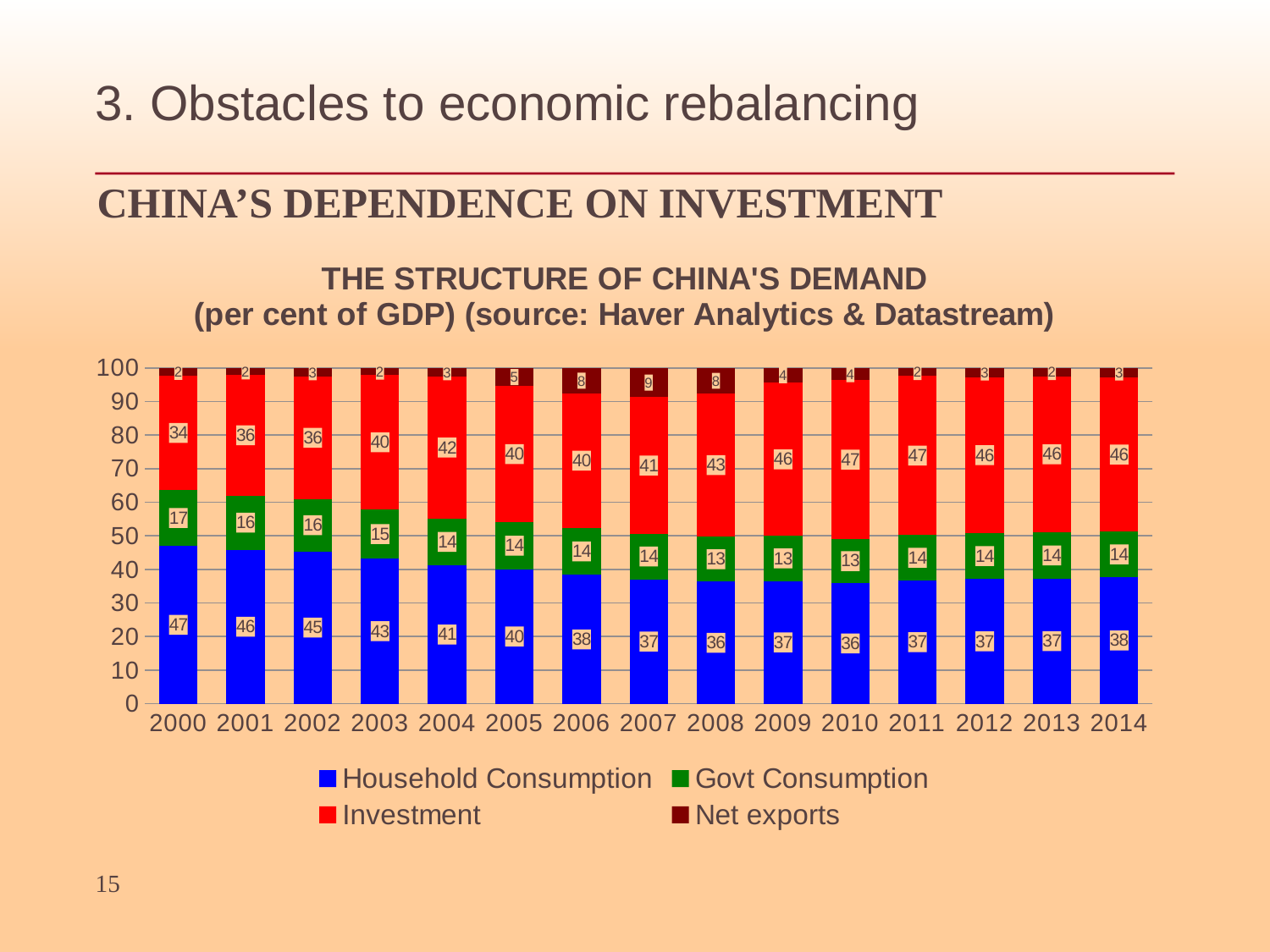
What is the Investment value for 2014? 46 What is the Household Consumption value for 2000? 47 In which year is Net exports highest? 2007 In which year is Household Consumption highest? 2000 What is the difference between the Investment value in 2014 and in 2000? 12 Does Household Consumption rise or fall from 2000 to 2010? fall What is the Net exports value for 2007? 9 How many series does the legend list? 4 What is the Govt Consumption value for 2008? 13 In which year is Investment lowest? 2000 Which is larger in 2004, Household Consumption or Investment? Investment How many years are shown on the x axis? 15